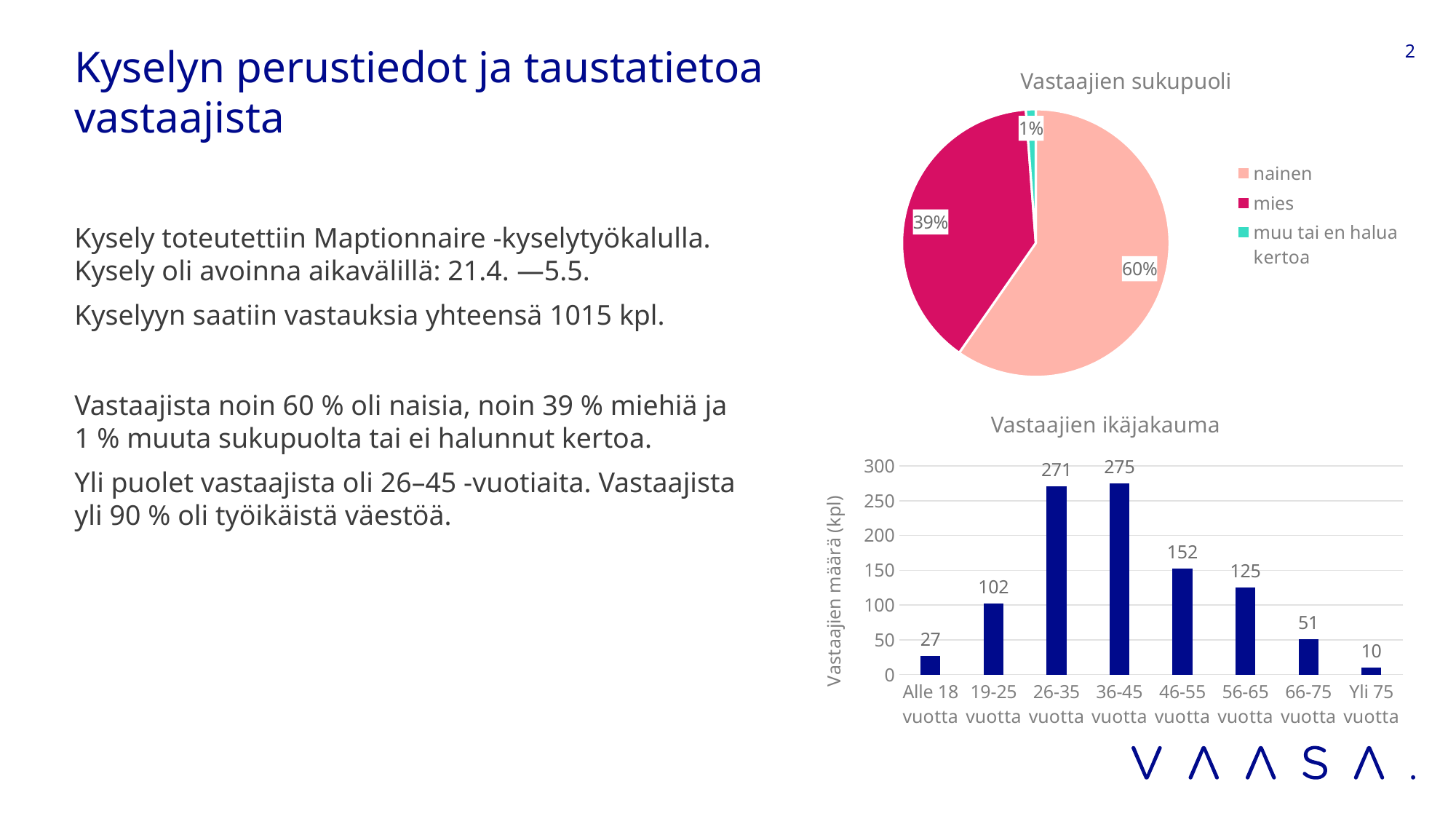
In the 'Vastaajien ikäjakauma' chart, what is the difference between '46-55 vuotta' and '56-65 vuotta'? 27 In the 'Vastaajien ikäjakauma' chart, what is the value for '19-25 vuotta'? 102 In the 'Vastaajien sukupuoli' chart, what share of respondents is 'nainen'? 60% In the 'Vastaajien sukupuoli' chart, what share of respondents is 'mies'? 39% In the 'Vastaajien ikäjakauma' chart, what is the y-axis label? Vastaajien määrä (kpl) What kind of chart is 'Vastaajien ikäjakauma'? bar chart In the 'Vastaajien ikäjakauma' chart, how many age groups are shown on the x axis? 8 In the 'Vastaajien ikäjakauma' chart, which is larger, '26-35 vuotta' or '66-75 vuotta'? 26-35 vuotta What kind of chart is 'Vastaajien sukupuoli'? pie chart In the 'Vastaajien sukupuoli' chart, how many categories does the legend list? 3 In the 'Vastaajien ikäjakauma' chart, what is the value for '36-45 vuotta'? 275 In the 'Vastaajien ikäjakauma' chart, which age group has the lowest value? Yli 75 vuotta